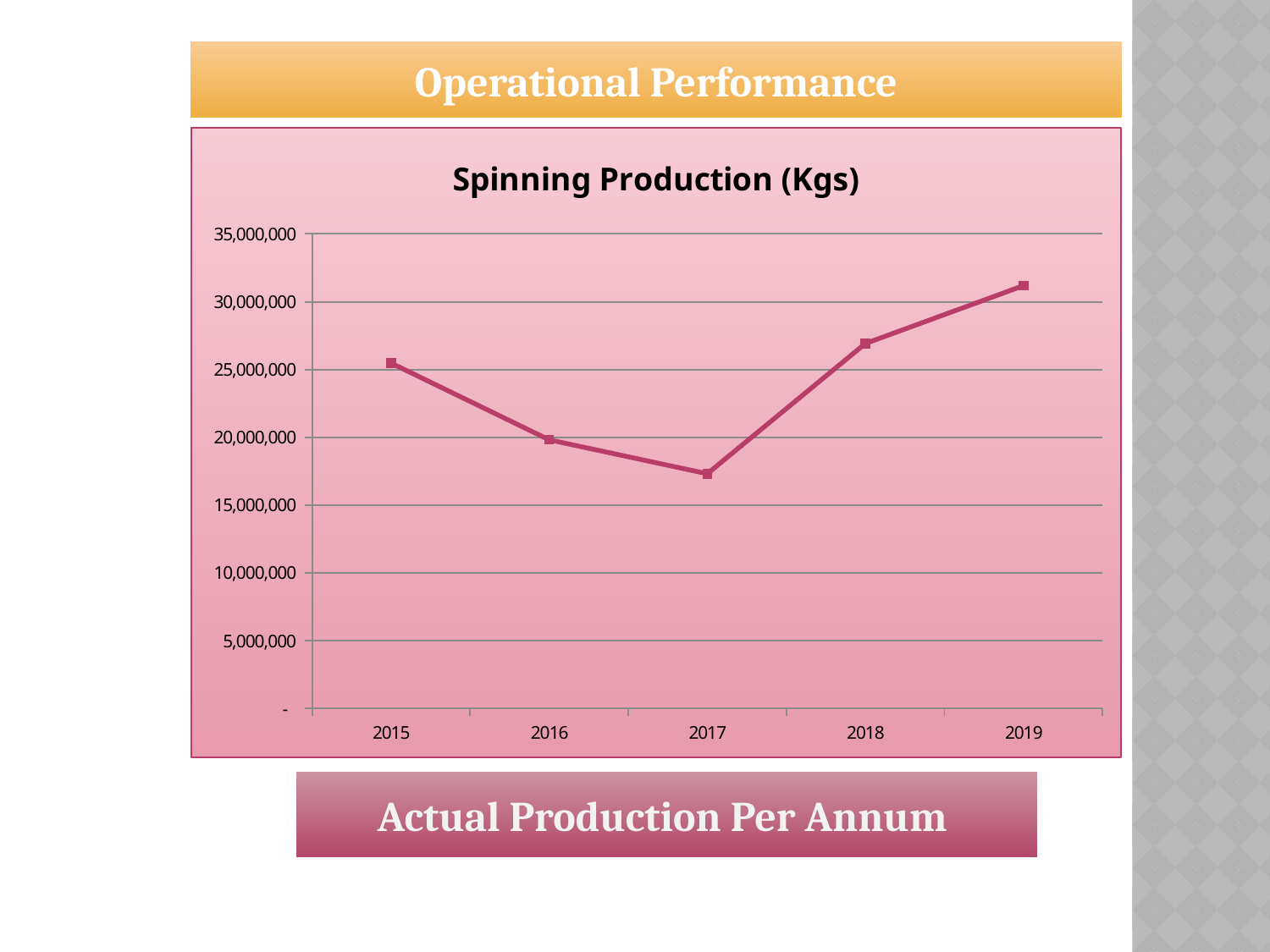
Which year has the highest spinning production? 2019 Which year has the lowest spinning production? 2017 Which year has higher spinning production, 2016 or 2018? 2018 Is the spinning production for 2017 greater or less than 20,000,000? less Is the spinning production for 2018 greater or less than 30,000,000? less Does spinning production rise or fall from 2017 to 2019? rise How many years are plotted on the x axis of the chart? 5 What kind of chart is shown on the slide? line chart What is the title of the chart? Spinning Production (Kgs) Is the spinning production for 2019 greater or less than 30,000,000? greater Does spinning production rise or fall from 2015 to 2017? fall